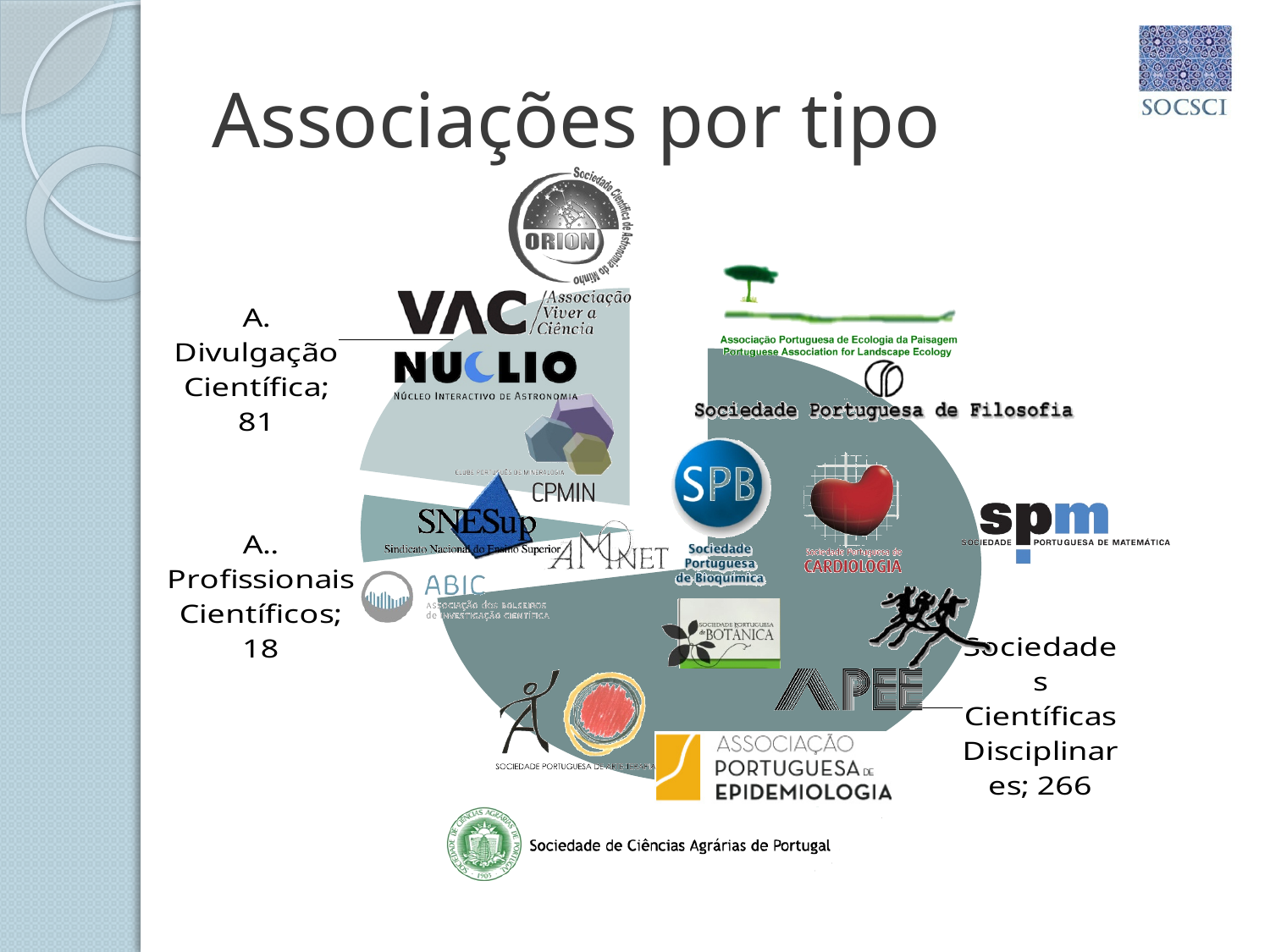
Which is larger, the value for A. Divulgação Científica or the value for A.. Profissionais Científicos? A. Divulgação Científica How many categories (slices) does the pie chart have? 3 What is the difference between the values for A. Divulgação Científica and A.. Profissionais Científicos? 63 What is the difference between the values for Sociedades Científicas Disciplinares and A. Divulgação Científica? 185 What is the value for A. Divulgação Científica? 81 Which category has the largest slice of the pie? Sociedades Científicas Disciplinares What is the total of all three slices in the pie chart? 365 What is the value for A.. Profissionais Científicos? 18 What is the title of the chart? Associações por tipo What is the value for Sociedades Científicas Disciplinares? 266 What type of chart is shown on the slide? pie chart Which category has the smallest slice of the pie? A.. Profissionais Científicos